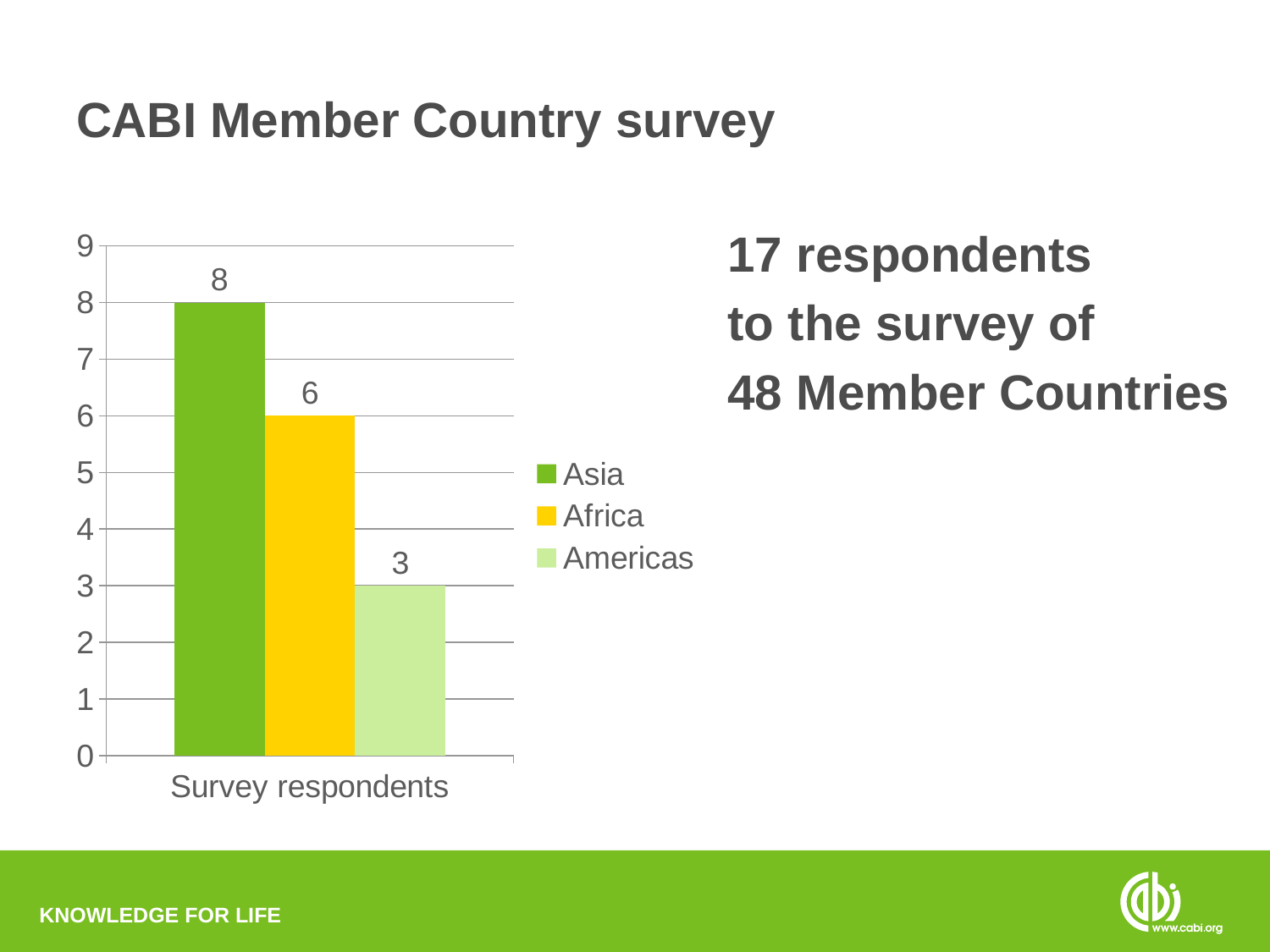
What is the difference between the values for Africa and Americas? 3 Is the value for Asia greater or less than 7? greater What kind of chart is shown on the slide? Bar chart What is the label on the x axis of the chart? Survey respondents What is the value for Americas in the Survey respondents chart? 3 Which is larger, the value for Africa or the value for Americas? Africa What is the difference between the values for Asia and Africa? 2 Which series has the highest value in the chart? Asia What is the value for Asia in the Survey respondents chart? 8 How many series does the legend list? 3 Which series has the lowest value in the chart? Americas What is the value for Africa in the Survey respondents chart? 6